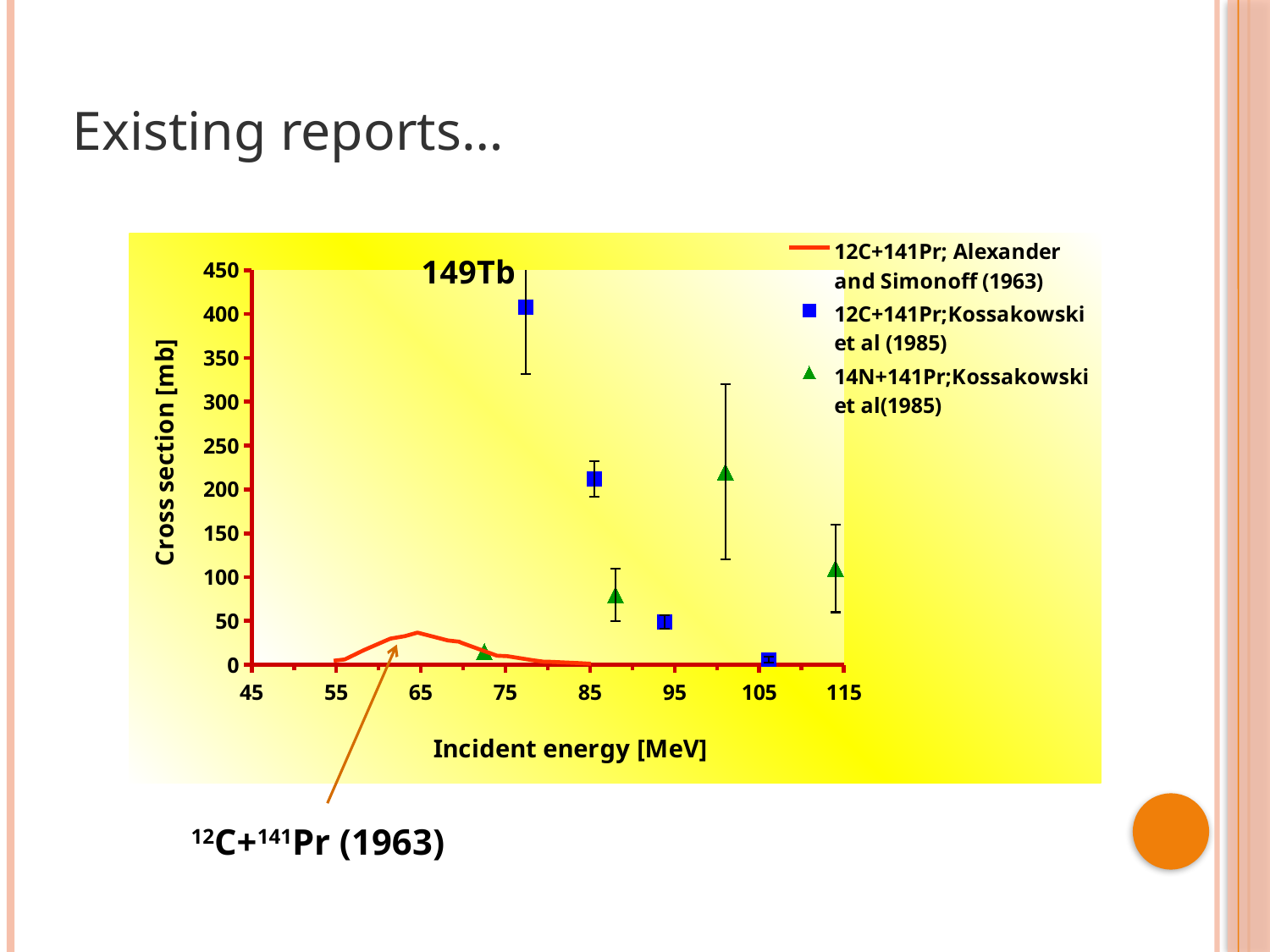
How many blue square data points (12C+141Pr; Kossakowski et al (1985)) are plotted? 4 Which is larger: the highest blue square point or the highest green triangle point? the highest blue square point Which series contains the single highest plotted point on the chart? 12C+141Pr; Kossakowski et al (1985) What is the title of the y axis? Cross section [mb] Do the blue square values (12C+141Pr; Kossakowski et al (1985)) rise or fall as incident energy increases? fall What kind of chart is shown on the slide? scatter chart with a line series Is the highest green triangle point (14N+141Pr; Kossakowski et al (1985)) greater or less than 150 mb? greater Is the highest blue square point (12C+141Pr; Kossakowski et al (1985)) greater or less than 350 mb? greater How many series does the legend list? 3 What is the title of the x axis? Incident energy [MeV] Is the peak of the red line (12C+141Pr; Alexander and Simonoff (1963)) greater or less than 50 mb? less How many green triangle data points (14N+141Pr; Kossakowski et al (1985)) are plotted? 4